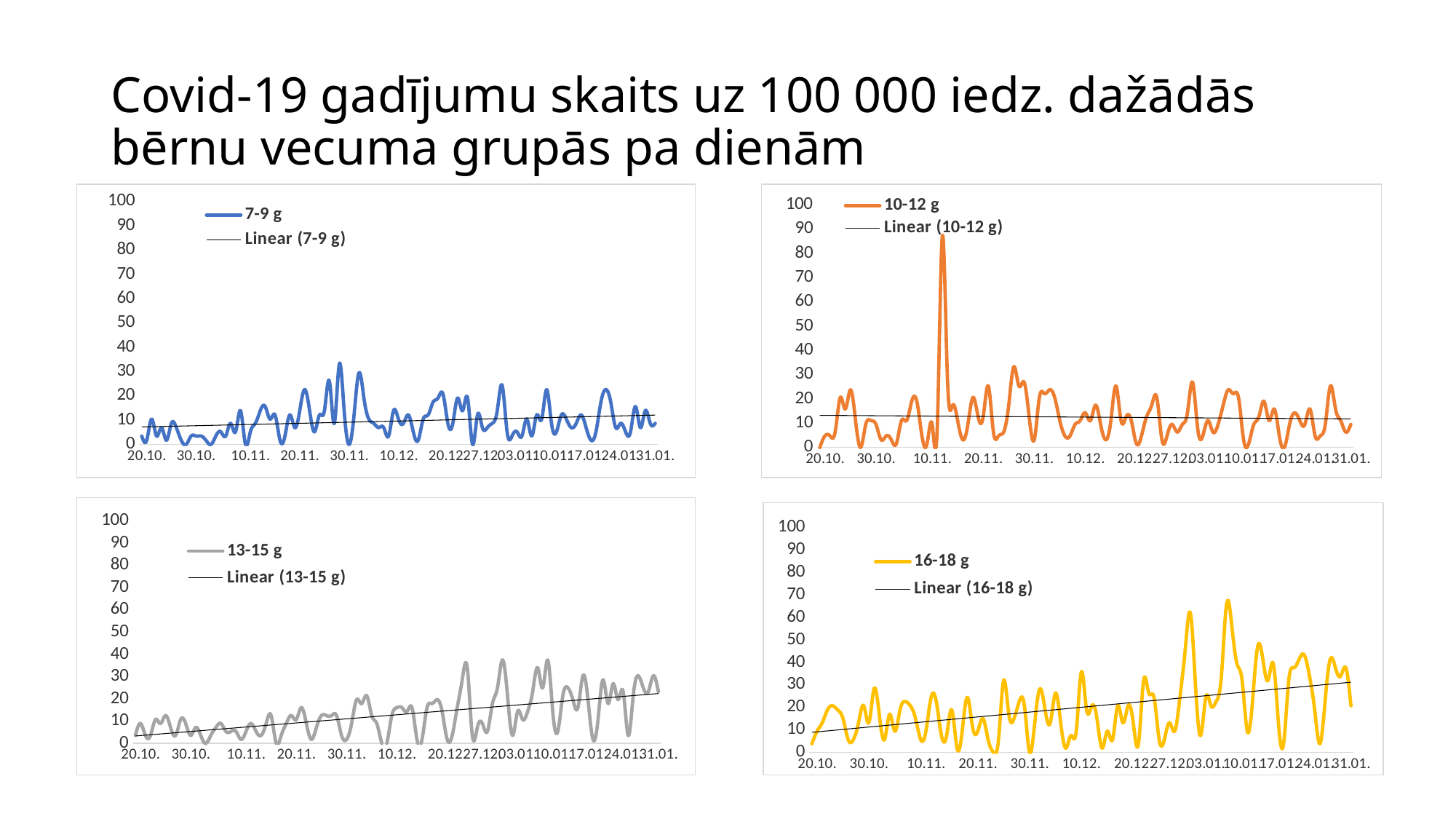
What colour is the data line in the bottom-right chart (16-18 g)? Yellow In the top-right chart (10-12 g), is the highest peak greater or less than 80? greater In the bottom-right chart (16-18 g), do the values generally rise or fall along the x axis? Rise What is the name of the data series in the top-right chart? 10-12 g In the bottom-right chart (16-18 g), is the highest peak greater or less than 60? greater What kind of chart is the top-left chart (7-9 g)? Line chart In the top-left chart (7-9 g), is the highest peak greater or less than 40? less In the bottom-left chart (13-15 g), do the values generally rise or fall along the x axis? Rise How many charts are shown on the slide? 4 In the top-right chart (10-12 g), how many entries does the legend list? 2 Which age group's chart shows the highest single peak on the slide? 10-12 g